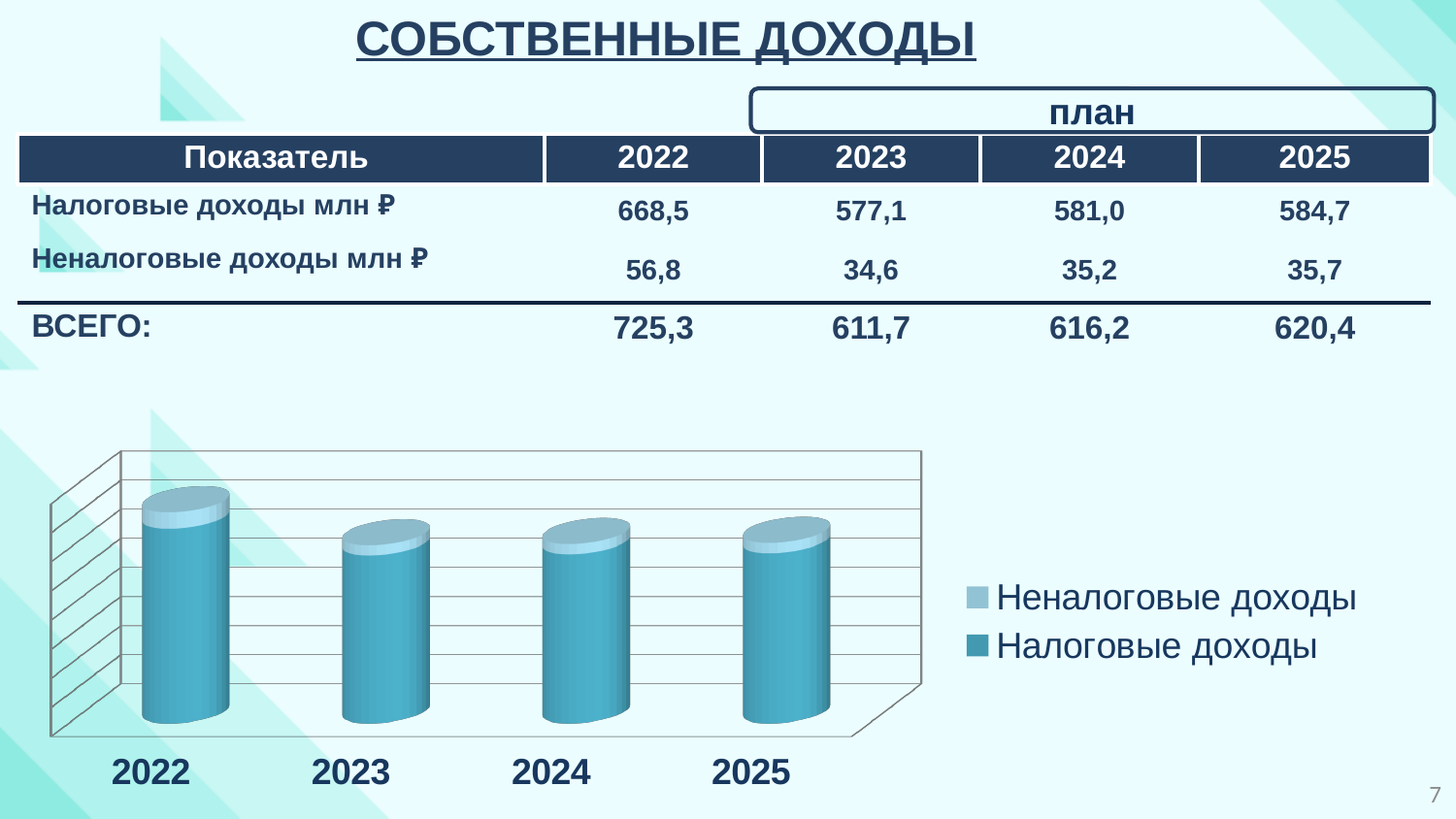
Do the total values in the table rise or fall from 2023 to 2025? rise According to the table on the slide, what is the value of Неналоговые доходы for 2025? 35,7 Which series is shown in the darker blue colour at the bottom of each bar? Налоговые доходы According to the table on the slide, what is the difference between Налоговые доходы in 2022 and 2023? 91,4 How many years are shown along the x axis of the chart? 4 According to the table on the slide, what is the value of Налоговые доходы for 2022? 668,5 According to the table on the slide, what is the total (ВСЕГО) for 2023? 611,7 Which series is shown in the lighter blue colour at the top of each bar? Неналоговые доходы Is the stacked bar for 2022 taller or shorter than the stacked bar for 2023? taller Which year has the tallest stacked bar in the chart? 2022 How many series does the chart legend list? 2 What kind of chart is shown on the slide? bar chart